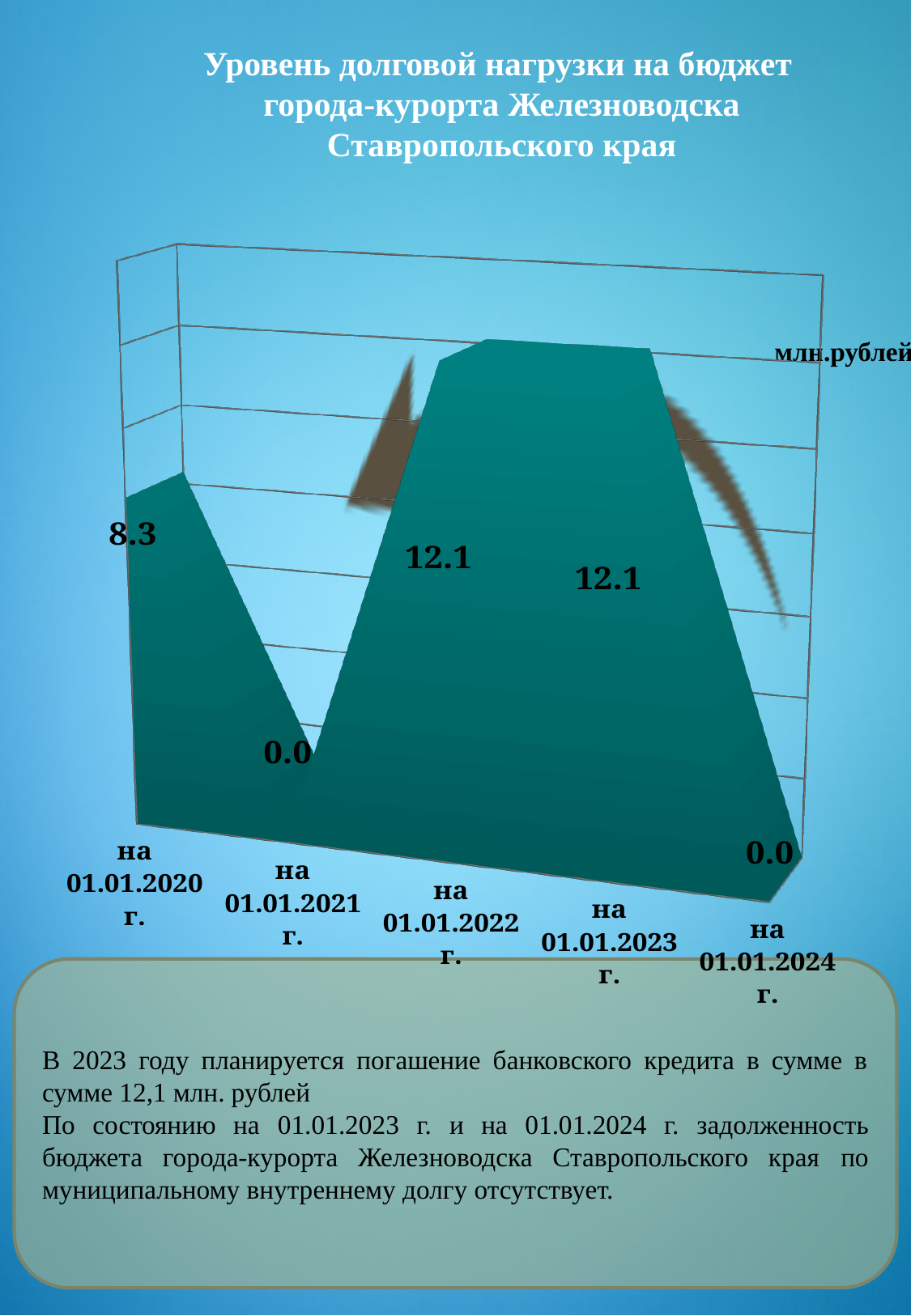
What unit is shown on the chart? млн.рублей How many dates are plotted on the chart? 5 Which date has the highest value on the chart? на 01.01.2022 г. and на 01.01.2023 г. (12.1) Which is larger, the value for на 01.01.2020 г. or the value for на 01.01.2023 г.? на 01.01.2023 г. What is the value for на 01.01.2022 г.? 12.1 What is the value for на 01.01.2021 г.? 0.0 What is the title of the chart? Уровень долговой нагрузки на бюджет города-курорта Железноводска Ставропольского края Does the value rise or fall from на 01.01.2023 г. to на 01.01.2024 г.? fall What is the value for на 01.01.2024 г.? 0.0 What kind of chart is shown on the slide? area chart What is the value for на 01.01.2020 г.? 8.3 What is the difference between the values for на 01.01.2022 г. and на 01.01.2020 г.? 3.8